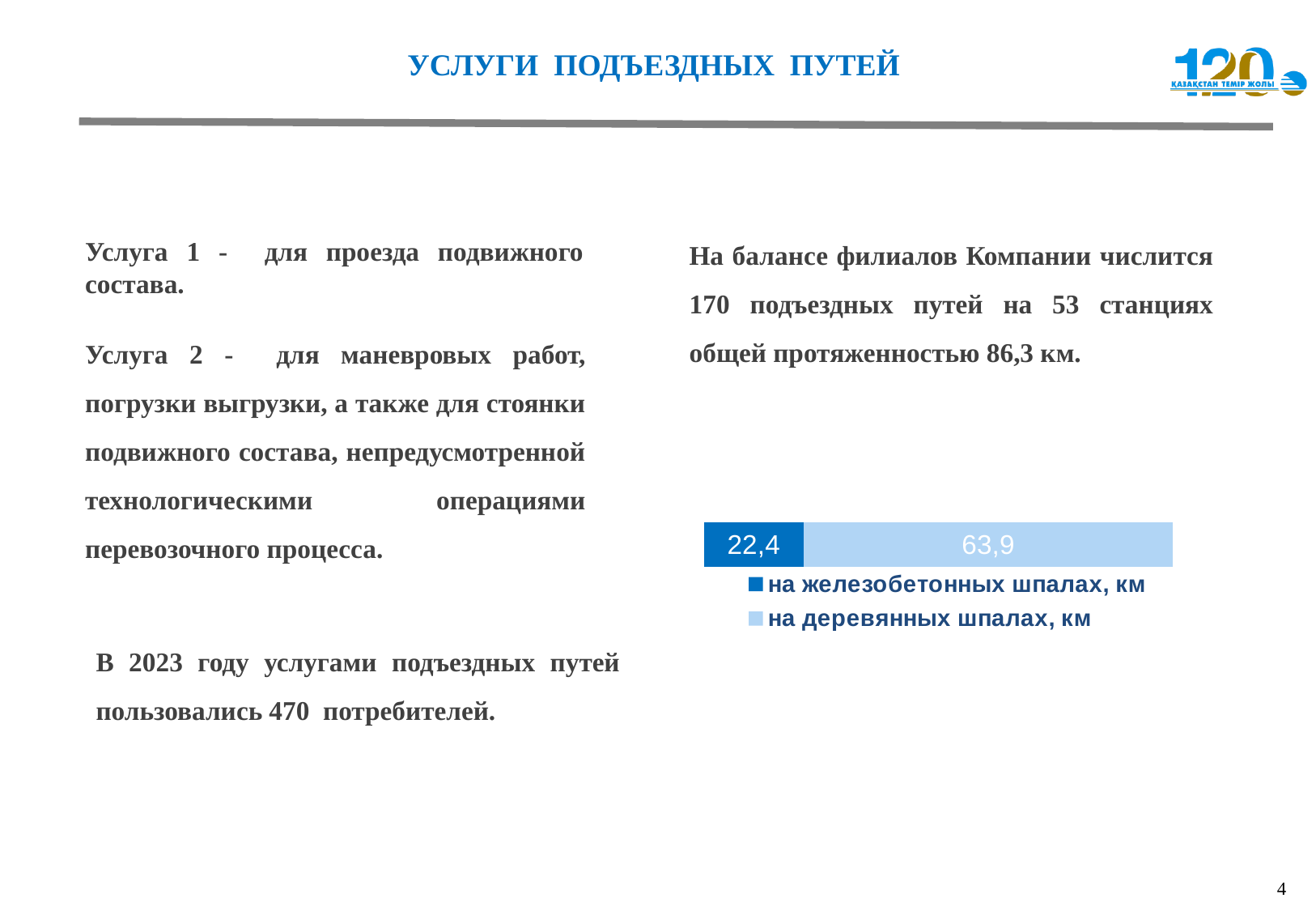
Which series has the smallest value in the chart? на железобетонных шпалах, км Which series has the largest value in the chart? на деревянных шпалах, км Which series has the larger value in the chart, 'на железобетонных шпалах, км' or 'на деревянных шпалах, км'? на деревянных шпалах, км What is the total of the stacked bar in the chart? 86,3 How many series does the chart legend list? 2 What is the value for 'на железобетонных шпалах, км' in the chart? 22,4 Which series is shown in the darker blue colour in the chart? на железобетонных шпалах, км What is the value for 'на деревянных шпалах, км' in the chart? 63,9 How many data labels are printed on the bar in the chart? 2 What kind of chart is shown on the slide? Stacked bar chart Which series is shown in the lighter blue colour in the chart? на деревянных шпалах, км What is the difference between the value for 'на деревянных шпалах, км' and the value for 'на железобетонных шпалах, км'? 41,5